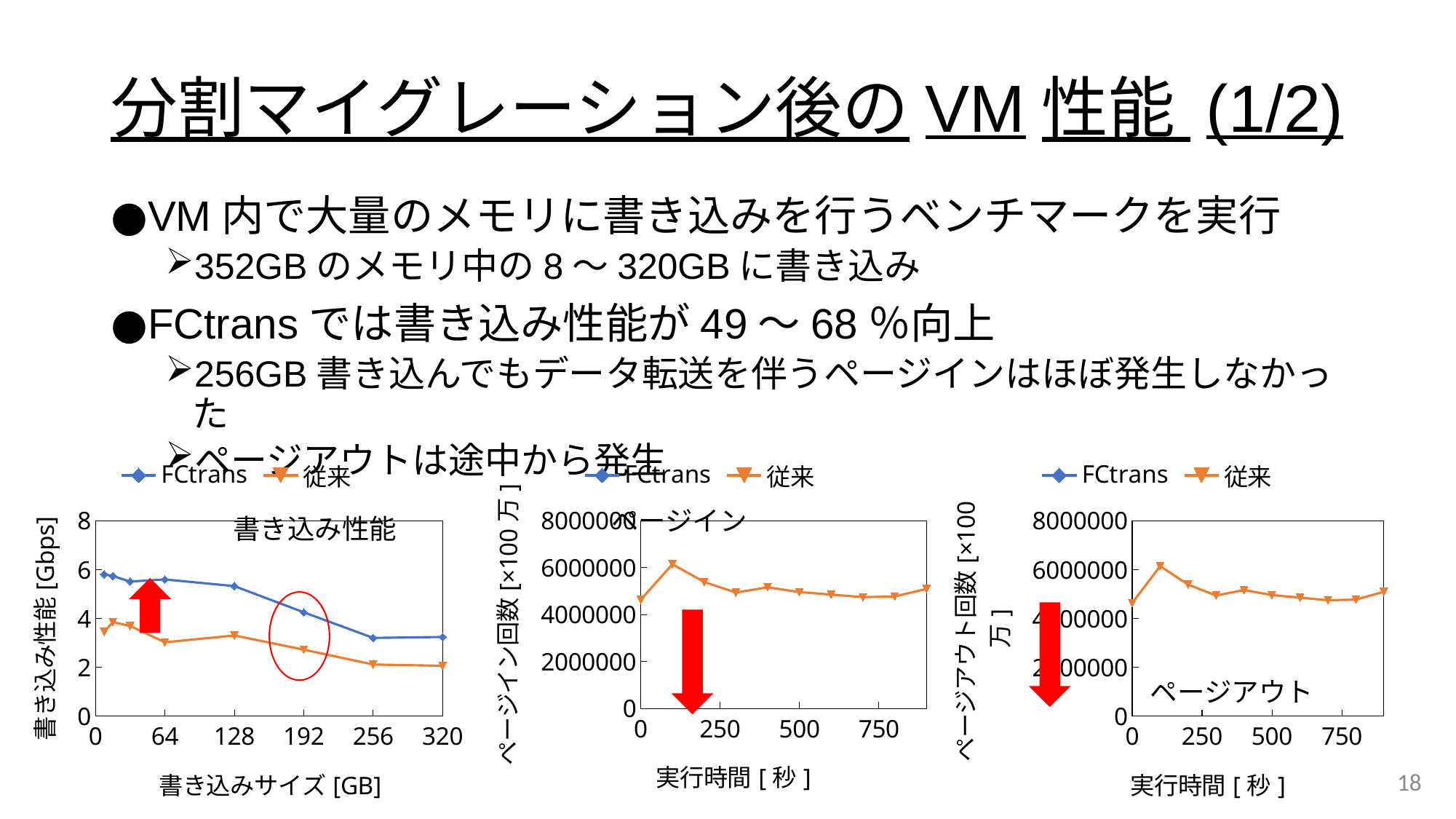
How many series does the legend of the 書き込み性能 chart list? 2 What is the x-axis title of the 書き込み性能 chart? 書き込みサイズ [GB] What kind of chart is the 書き込み性能 chart? line chart In the 書き込み性能 chart, is the 従来 value at 256 GB greater or less than 4? less In the 書き込み性能 chart, is the FCtrans value at 64 GB greater or less than 4? greater In the 書き込み性能 chart, does the FCtrans line rise or fall as the write size increases from 64 to 320 GB? fall What is the x-axis title of the ページアウト chart? 実行時間 [ 秒 ] In the ページイン chart, is the 従来 value at 0 seconds greater or less than 6000000? less What kind of chart is the ページイン chart? line chart In the 書き込み性能 chart, which series has the higher value at 64 GB, FCtrans or 従来? FCtrans In the 書き込み性能 chart, which series has the higher value at 320 GB, FCtrans or 従来? FCtrans